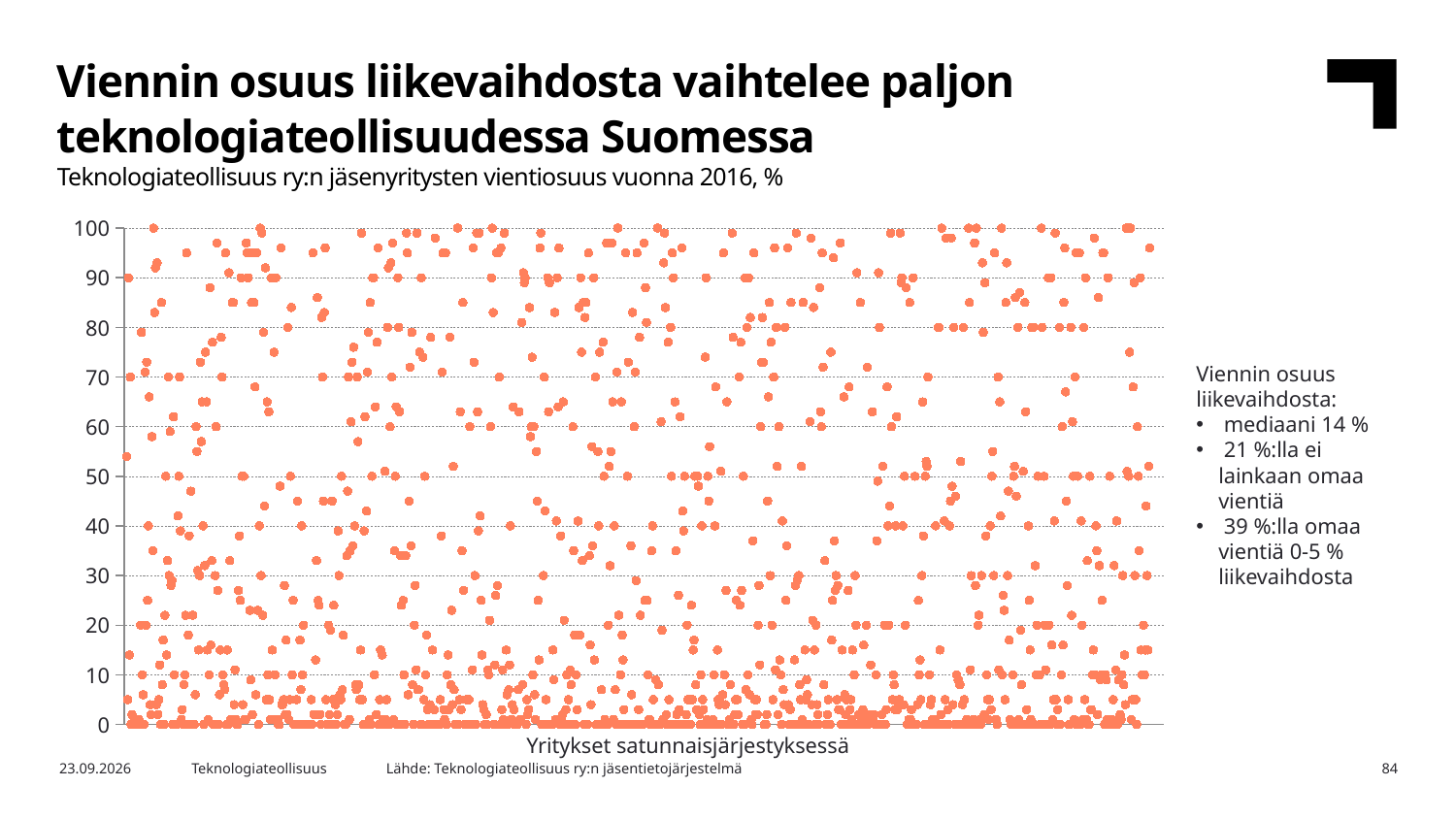
Which year does the chart's data refer to? 2016 According to the text next to the chart, what is the median export share of turnover? 14 % How many data series are plotted in the chart? 1 According to the text next to the chart, what percentage of companies have no exports at all? 21 % What colour are the data points in the chart? orange What is the highest value shown on the y axis of the chart? 100 What kind of chart is shown on the slide? scatter chart What is the lowest value shown on the y axis of the chart? 0 According to the text next to the chart, what percentage of companies have exports of 0-5 % of turnover? 39 % What is the interval between the tick marks on the y axis? 10 What is the label on the x axis of the chart? Yritykset satunnaisjärjestyksessä